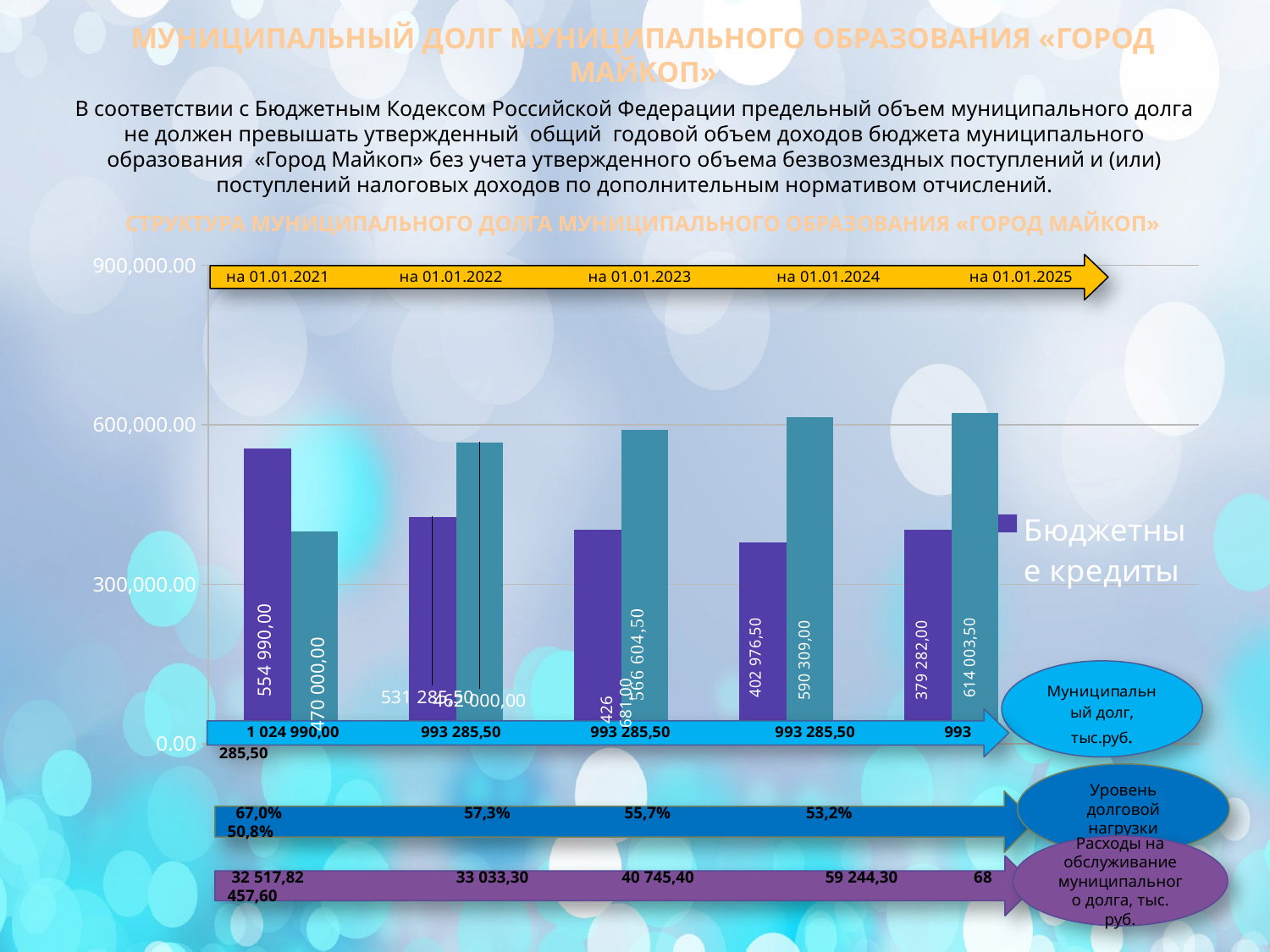
For which date is the teal bar the highest? на 01.01.2025 What series name is shown in the chart legend? Бюджетные кредиты What is the value of the purple bar (Бюджетные кредиты) for на 01.01.2021? 554 990,00 Do the values of the purple bars (Бюджетные кредиты) rise or fall from на 01.01.2021 to на 01.01.2025? fall For на 01.01.2023, which bar is larger, the purple one or the teal one? the teal one How many dates (categories) are shown along the x axis of the chart? 5 What is the value of the purple bar (Бюджетные кредиты) for на 01.01.2024? 402 976,50 What is the value of the teal bar for на 01.01.2025? 614 003,50 What kind of chart is shown on the slide? bar chart What is the difference between the purple bar and the teal bar for на 01.01.2021? 84 990,00 Is the value of the teal bar for на 01.01.2021 greater or less than 600,000.00? less